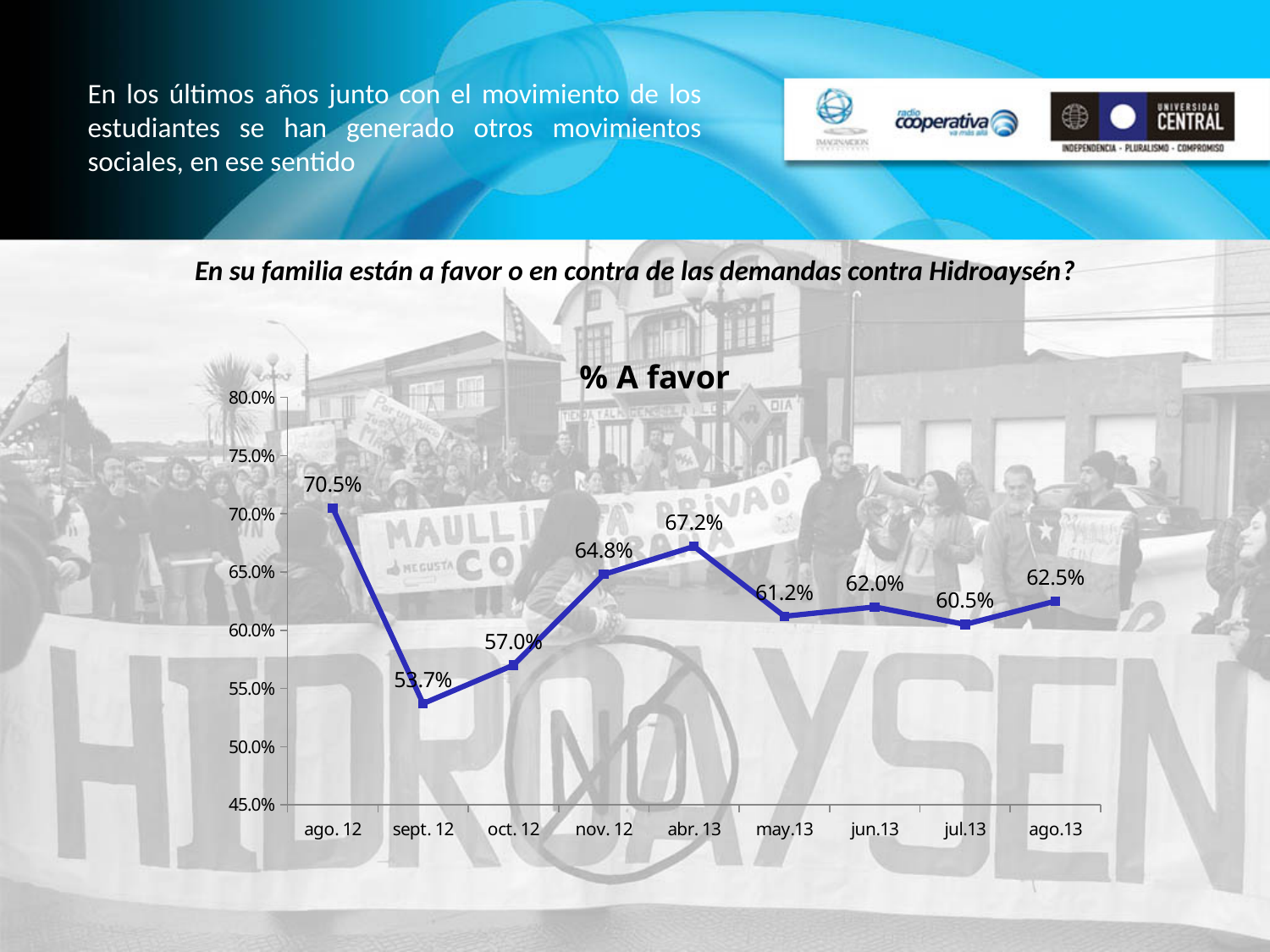
What is the value for ago. 12 in the "% A favor" chart? 70.5% Which is larger in the "% A favor" chart, the value for nov. 12 or the value for may.13? nov. 12 How many data points are plotted in the "% A favor" chart? 9 Does the value rise or fall from ago. 12 to sept. 12 in the "% A favor" chart? fall What is the value for abr. 13 in the "% A favor" chart? 67.2% Is the value for oct. 12 in the "% A favor" chart greater or less than 60.0%? less Which month has the lowest value in the "% A favor" chart? sept. 12 What is the value for jul.13 in the "% A favor" chart? 60.5% What kind of chart is the "% A favor" chart? line chart Which month has the highest value in the "% A favor" chart? ago. 12 What is the value for sept. 12 in the "% A favor" chart? 53.7% What is the difference between the values for ago. 12 and sept. 12 in the "% A favor" chart? 16.8%